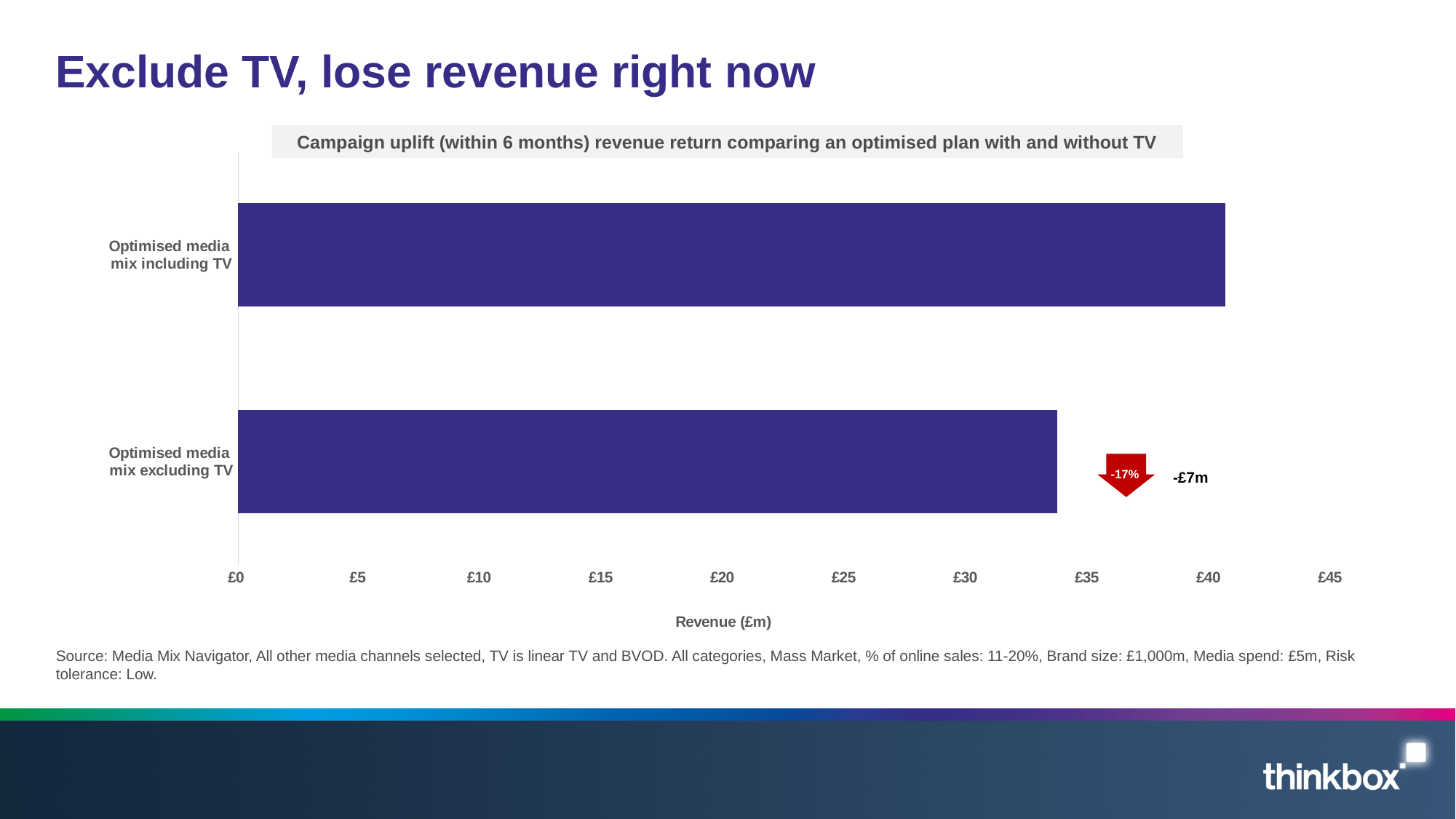
What is the label of the x axis? Revenue (£m) What is the title of the chart? Campaign uplift (within 6 months) revenue return comparing an optimised plan with and without TV Which category has the higher revenue return? Optimised media mix including TV Is the value for the optimised media mix excluding TV greater or less than £30? greater What kind of chart is shown on the slide? bar chart Which is larger: the revenue for the optimised media mix including TV or excluding TV? Optimised media mix including TV Which category has the lower revenue return? Optimised media mix excluding TV Is the value for the optimised media mix excluding TV greater or less than £35? less According to the annotation on the chart, how much revenue is lost by excluding TV? -£7m What percentage change is shown in the red arrow annotation next to the excluding-TV bar? -17% Is the value for the optimised media mix including TV greater or less than £35? greater How many categories (bars) does the chart show? 2